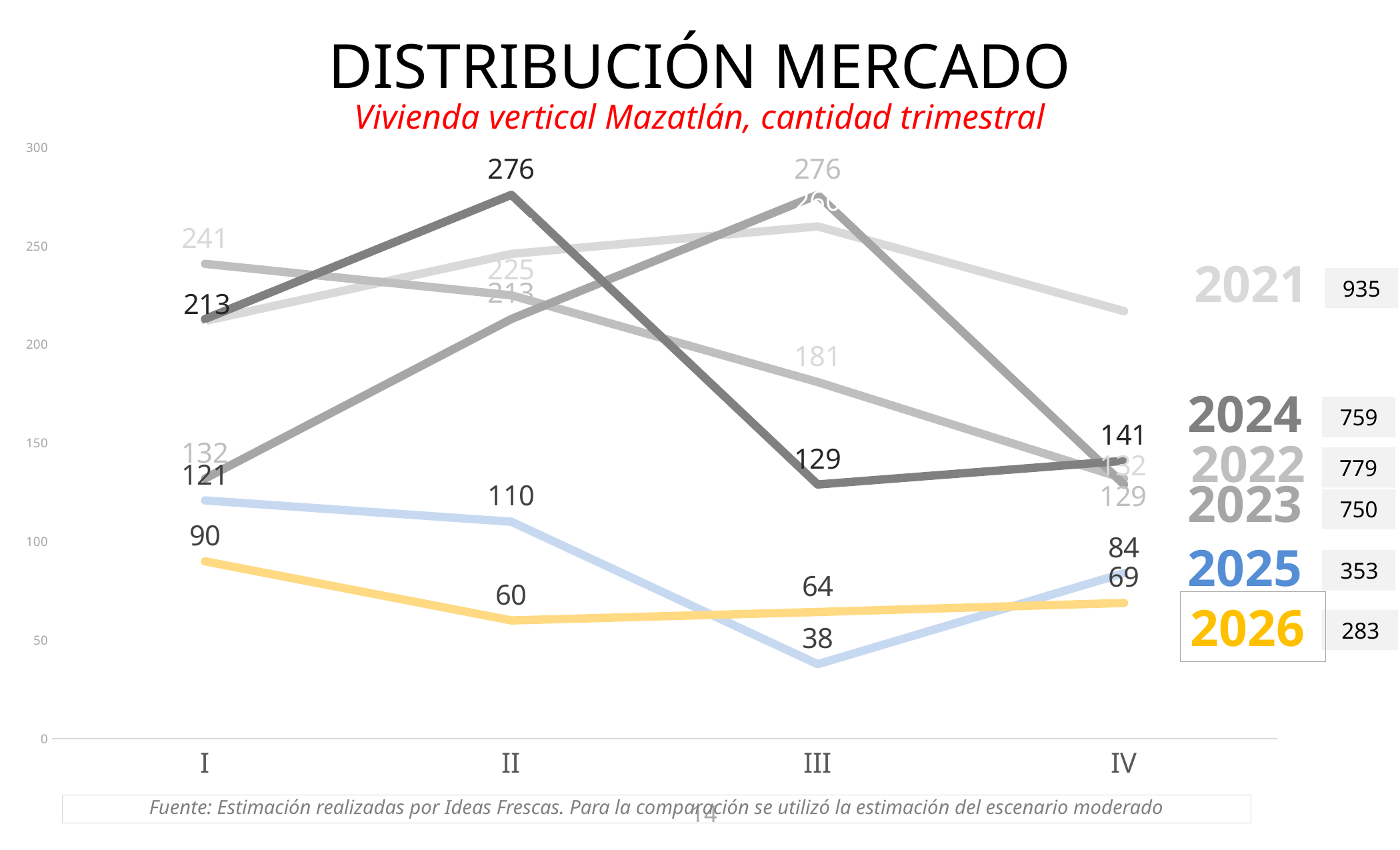
According to the legend, what is the annual total for 2021? 935 In quarter IV, which series has the larger value, 2025 or 2026? 2025 How many series (years) does the legend list? 6 How many quarters are shown on the x axis? 4 In which quarter does the 2025 series reach its highest value? I What is the difference between the 2024 values in quarter II and quarter III? 147 In which quarter does the 2026 series have its lowest value? II What kind of chart is shown on the slide? Line chart What is the value for 2024 in quarter II? 276 What is the value for 2025 in quarter III? 38 Which year has the highest annual total shown in the legend? 2021 What is the value for 2026 in quarter I? 90